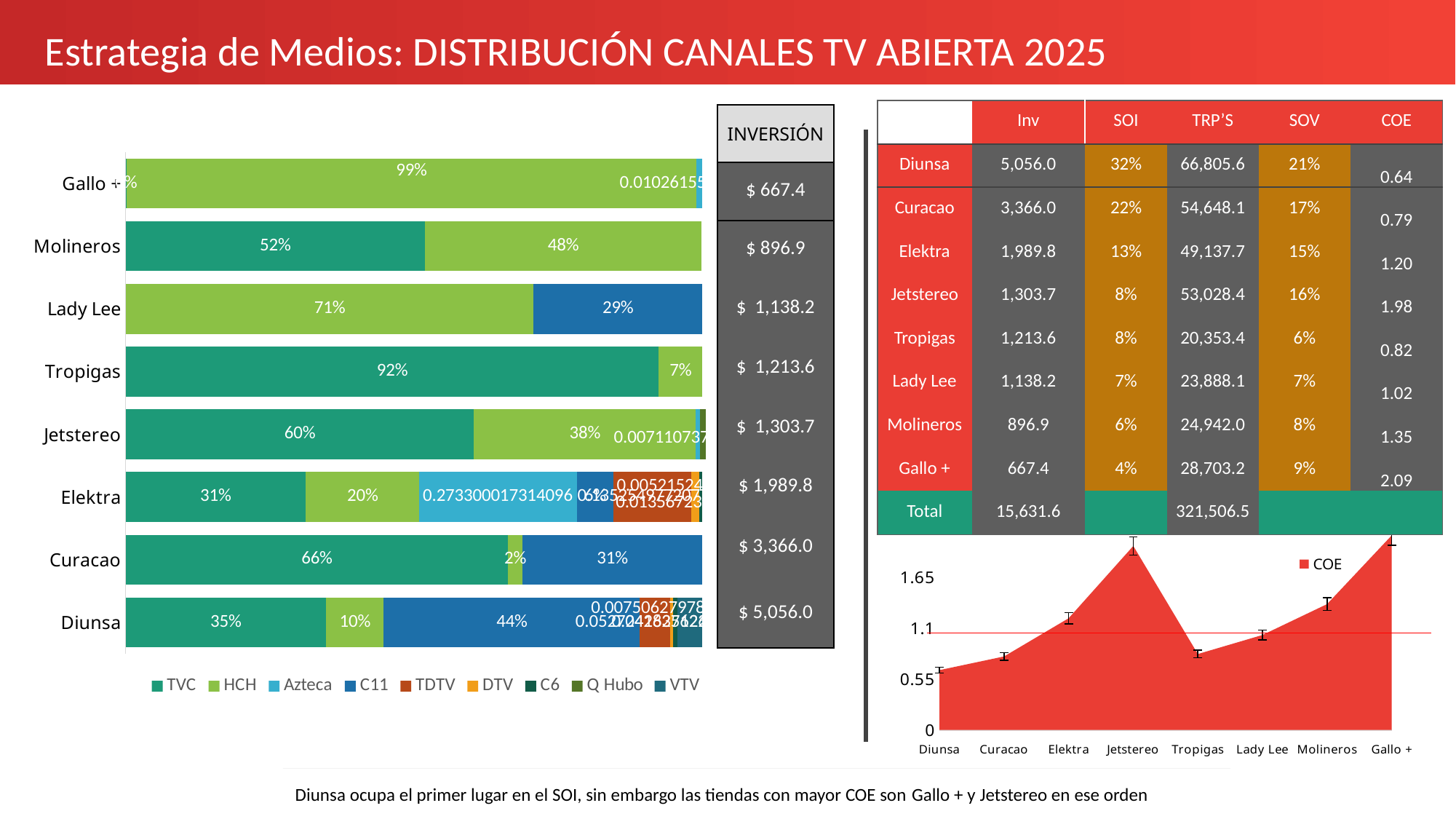
In the left bar chart, which is larger for Curacao: the TVC share or the C11 share? TVC In the left bar chart, what is the HCH share for Lady Lee? 71% In the left bar chart, what is the difference between the TVC and HCH shares for Molineros? 4% In the COE chart on the right, is the value for Jetstereo greater or less than 1.65? greater How many series does the legend of the left bar chart list? 9 In the left bar chart, what is the C11 share for Diunsa? 44% What kind of chart is the COE chart on the right of the slide? area chart In the COE chart on the right, which store has the highest value? Gallo + How many stores are shown on the left bar chart? 8 What kind of chart is the chart on the left of the slide? bar chart In the left bar chart, what is the TVC share for Tropigas? 92% In the COE chart on the right, is the value for Diunsa greater or less than 1.1? less